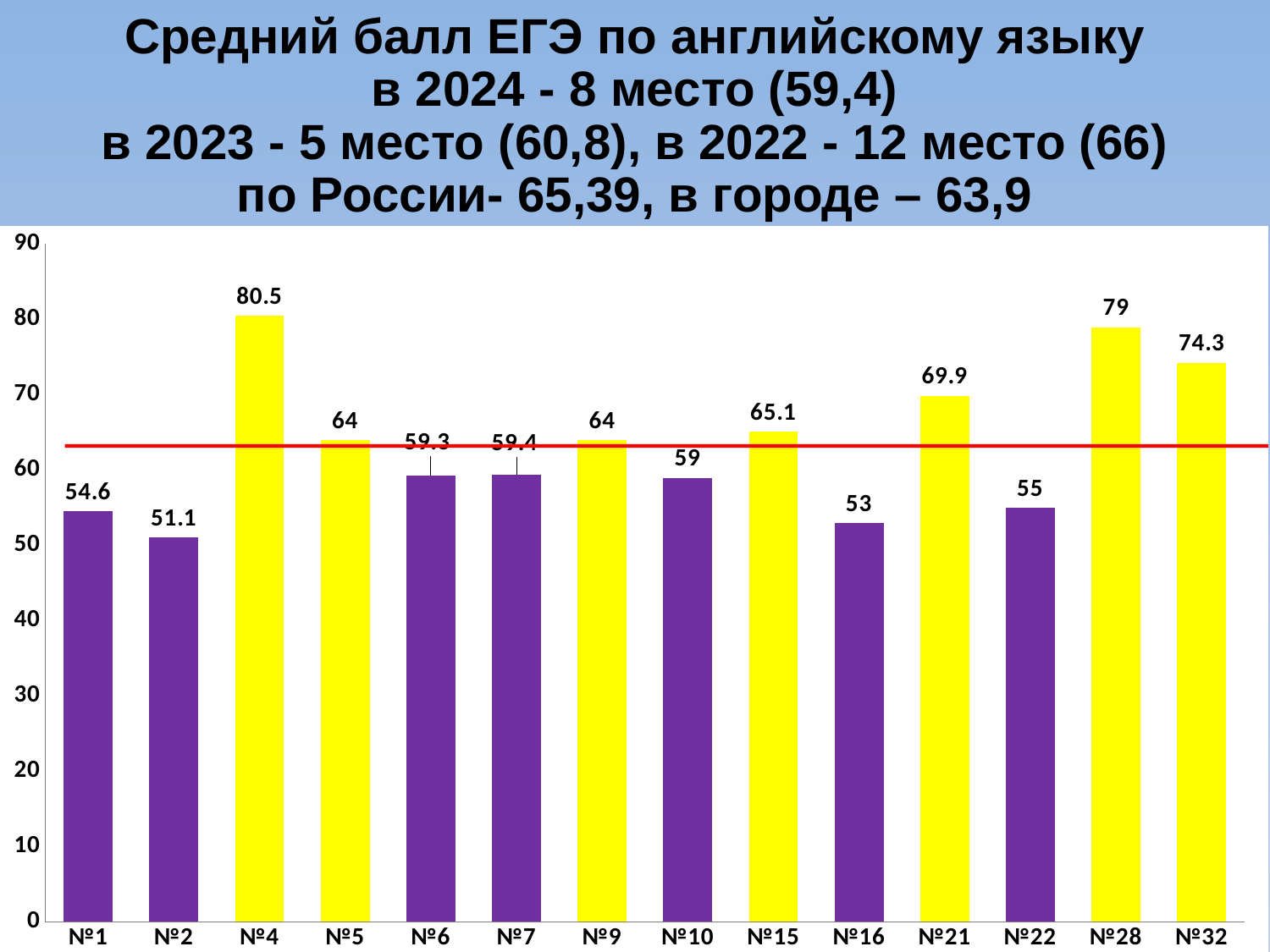
What is the value for №21? 69.9 Is the value for №10 greater or less than 70? less Which category has the highest value? №4 What kind of chart is shown on the slide? bar chart Which category has the lowest value? №2 What is the value for №4? 80.5 Which is larger, the value for №15 or the value for №16? №15 What is the difference between the values for №28 and №32? 4.7 What is the difference between the values for №4 and №2? 29.4 What colour is the horizontal reference line drawn across the chart? red How many categories are shown on the x axis? 14 What is the value for №2? 51.1